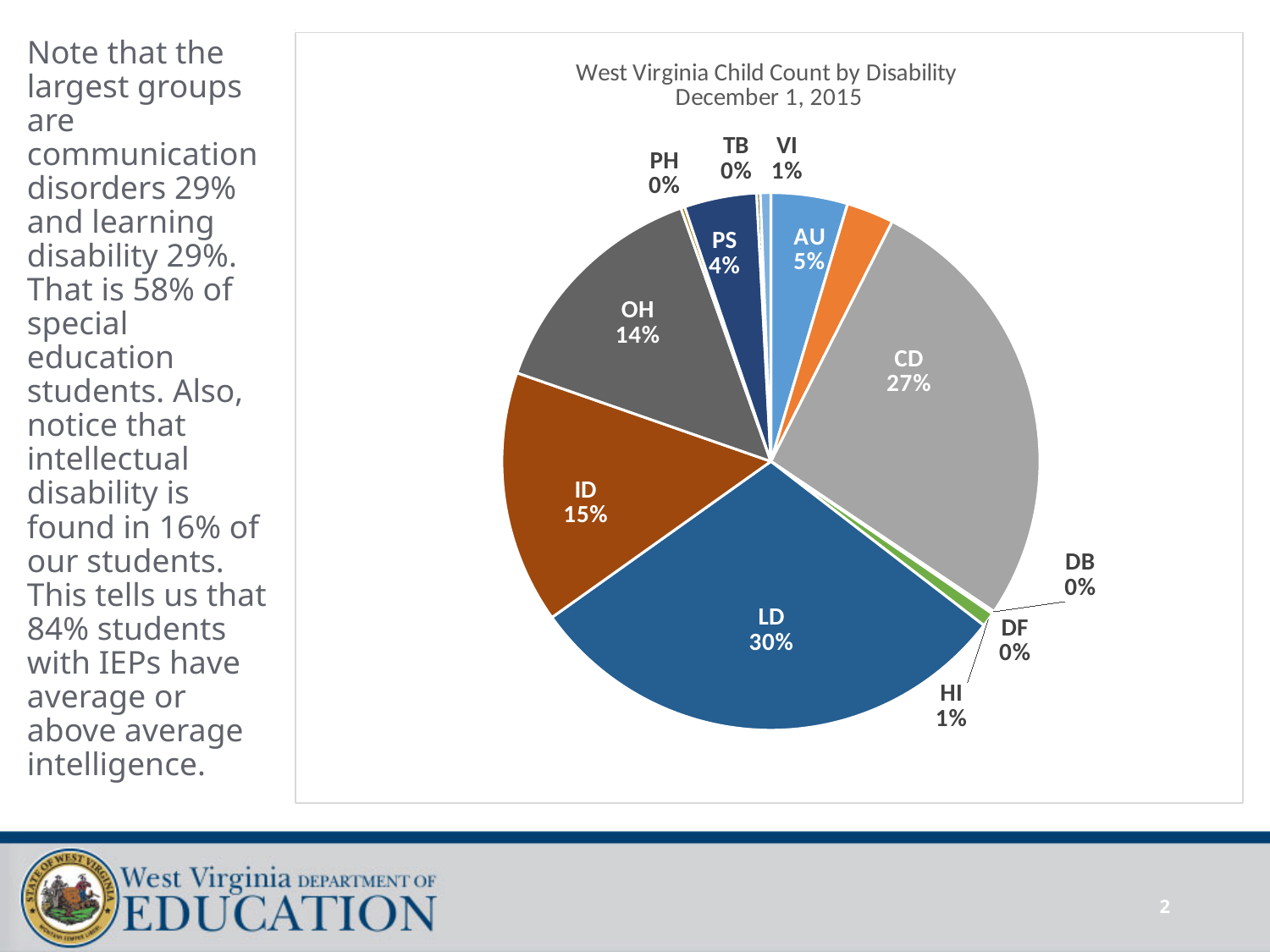
What share of the pie does the VI slice represent? 1% What percentage is shown for AU? 5% What percentage is shown for CD? 27% What kind of chart is shown on the slide? Pie chart Which has a larger share, ID or OH? ID What is the title of the chart? West Virginia Child Count by Disability December 1, 2015 Which disability category has the largest share of the pie? LD What percentage is shown for OH? 14% What percentage of the pie is the LD slice? 30% What percentage is shown for PS? 4% What percentage is shown for ID? 15% How many percentage points larger is LD than CD? 3